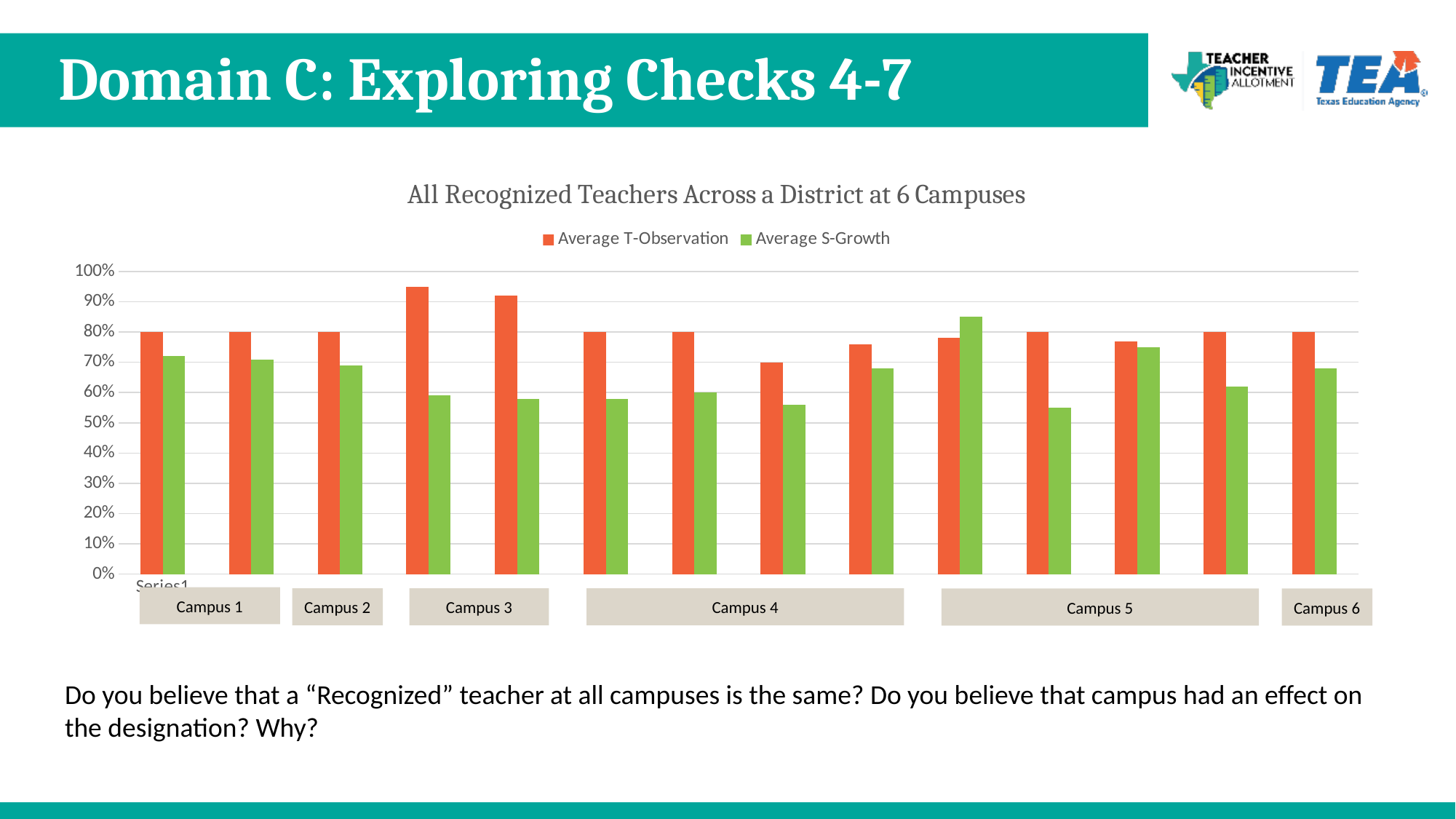
What is the title of the chart? All Recognized Teachers Across a District at 6 Campuses Is the Average S-Growth value for Campus 2 greater or less than 60%? greater For Campus 2, which is larger: Average T-Observation or Average S-Growth? Average T-Observation Which campus contains the tallest Average T-Observation bar? Campus 3 For Campus 6, which is larger: Average T-Observation or Average S-Growth? Average T-Observation Which campus contains the tallest Average S-Growth bar? Campus 5 What type of chart is shown on the slide? bar chart How many campuses are labelled along the x axis? 6 Which colour represents Average S-Growth in the chart? green Is the tallest Average T-Observation bar greater or less than 90%? greater How many series does the legend list? 2 Which campus contains the shortest Average T-Observation bar? Campus 4